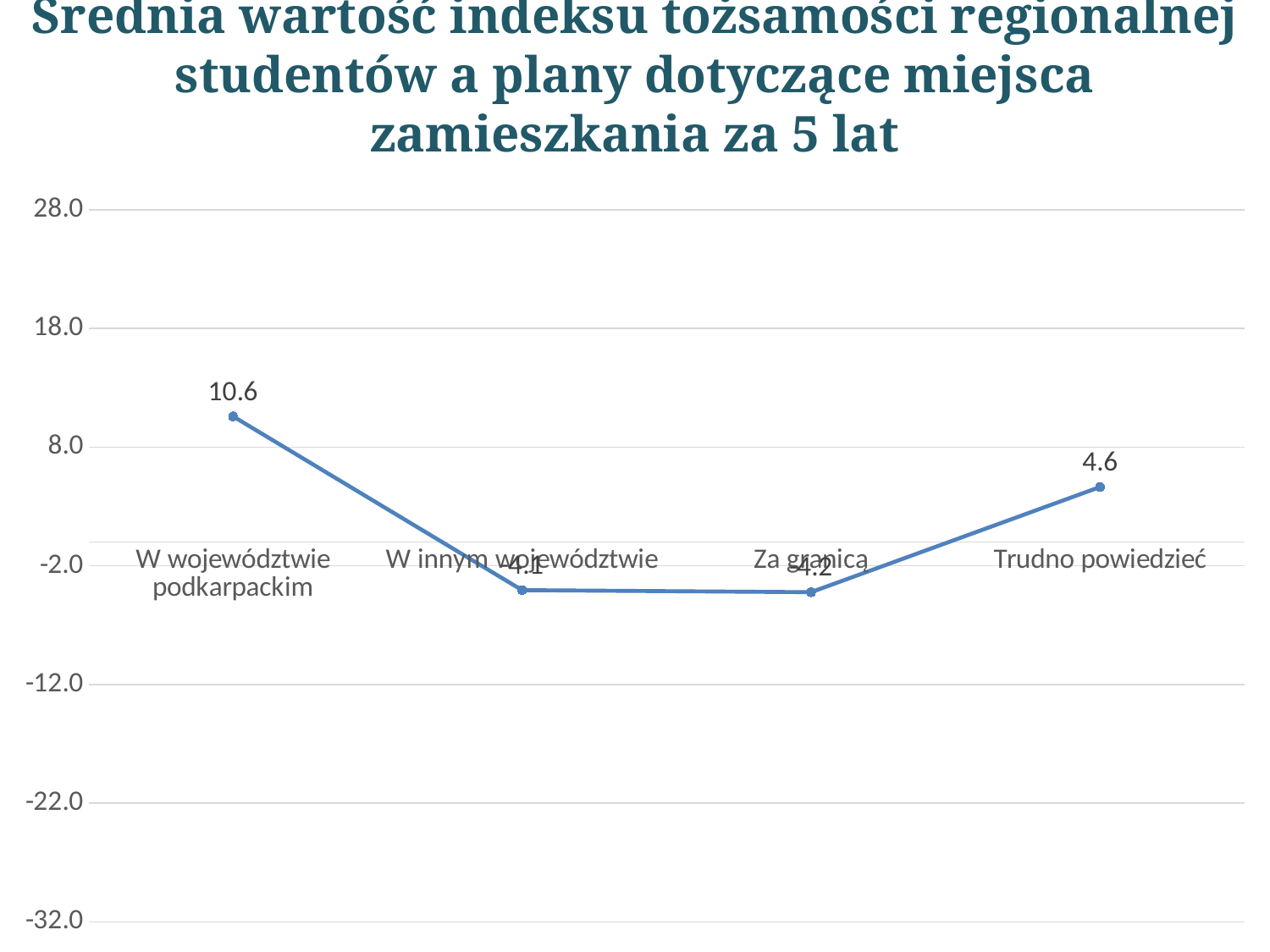
Which category has the highest value on the chart? W województwie podkarpackim Does the line rise or fall from 'W województwie podkarpackim' to 'W innym województwie'? fall What is the average regional identity index value for students planning to live 'W województwie podkarpackim'? 10.6 What is the highest value shown on the vertical axis? 28.0 Which is larger, the value for 'W województwie podkarpackim' or the value for 'Trudno powiedzieć'? W województwie podkarpackim How many categories are plotted along the x axis? 4 What type of chart is shown on the slide? line chart Is the value for 'Za granicą' greater or less than -2.0? less What is the value plotted for 'Trudno powiedzieć'? 4.6 What is the difference between the values for 'W województwie podkarpackim' and 'Trudno powiedzieć'? 6.0 Is the value for 'W województwie podkarpackim' greater or less than 8.0? greater Is the value for 'W innym województwie' greater or less than -2.0? less